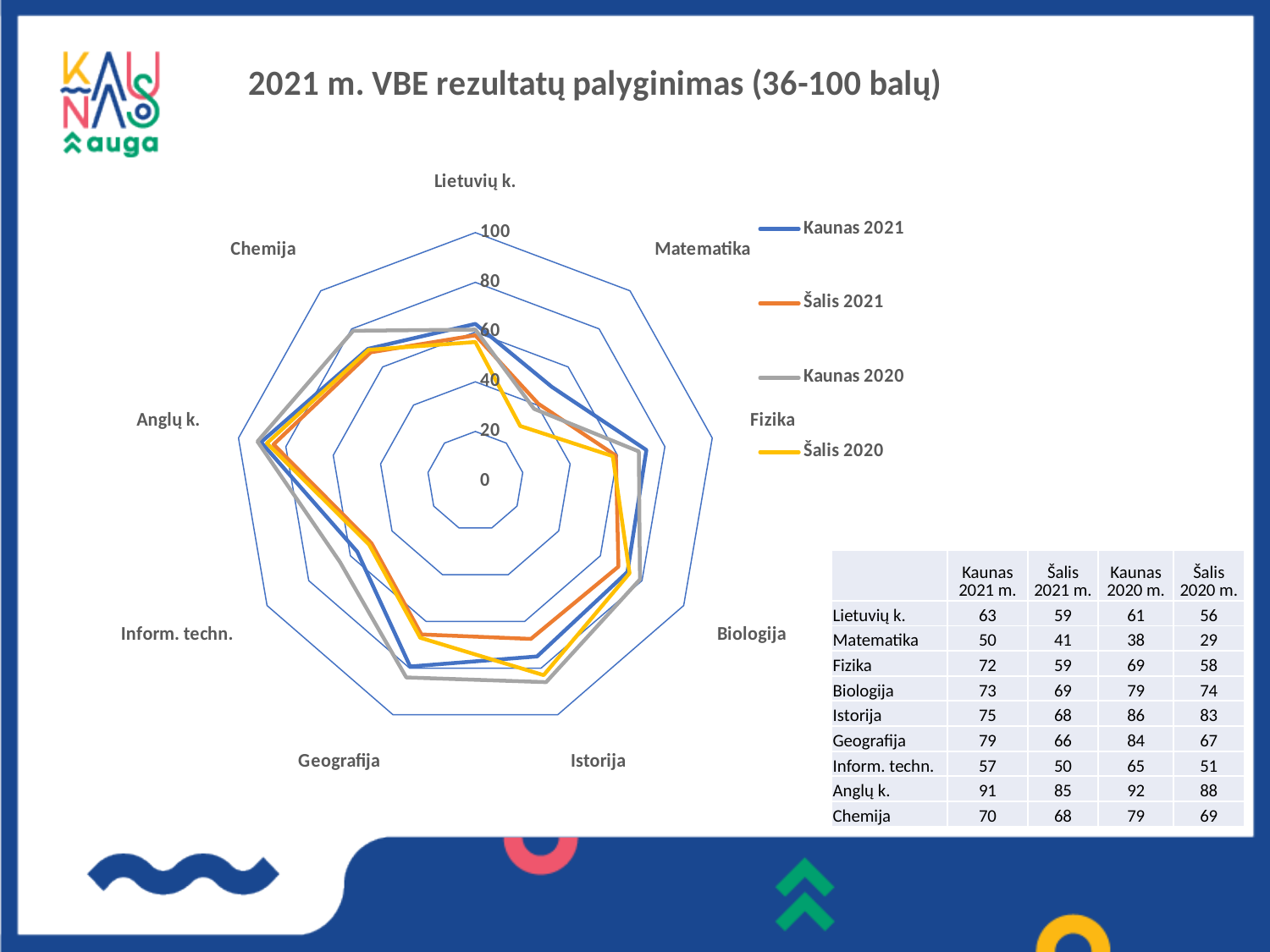
Which subject has the lowest Šalis 2021 value? Matematika How many series does the chart legend list? 4 What is the Kaunas 2021 value for Anglų k.? 91 Is the Kaunas 2021 value for Inform. techn. greater or less than 60? less What is the Kaunas 2020 value for Istorija? 86 What is the title of the chart? 2021 m. VBE rezultatų palyginimas (36-100 balų) What is the Šalis 2020 value for Matematika? 29 Which is larger for Biologija: Kaunas 2021 or Kaunas 2020? Kaunas 2020 Which subject has the highest Kaunas 2021 value? Anglų k. What is the difference between the Kaunas 2021 and Šalis 2021 values for Geografija? 13 What kind of chart is shown on the slide? radar chart How many subject categories are plotted on the radar chart? 9